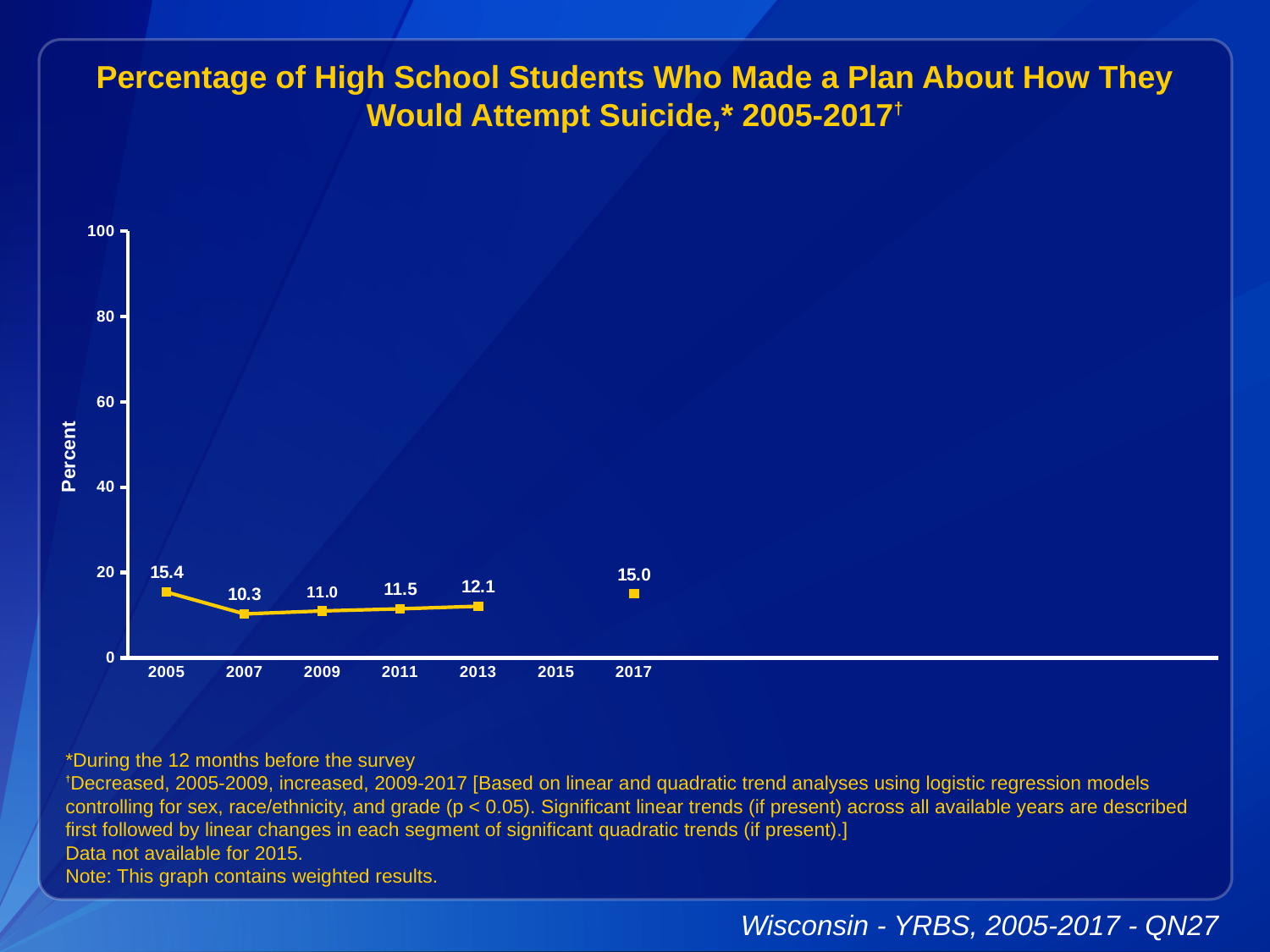
Which year has the highest plotted value? 2005 Which is larger, the value for 2011 or the value for 2013? 2013 What is the value plotted for 2009? 11.0 What is the difference between the 2017 value and the 2013 value? 2.9 How many years have a plotted data point on the chart? 6 Is the value for 2005 greater or less than 20? less What kind of chart is shown on the slide? line chart What is the value plotted for 2017? 15.0 Which year has the lowest plotted value? 2007 What percentage of high school students made a plan about how they would attempt suicide in 2005? 15.4 What is the difference between the 2005 value and the 2007 value? 5.1 Do the plotted values rise or fall from 2007 to 2013? rise